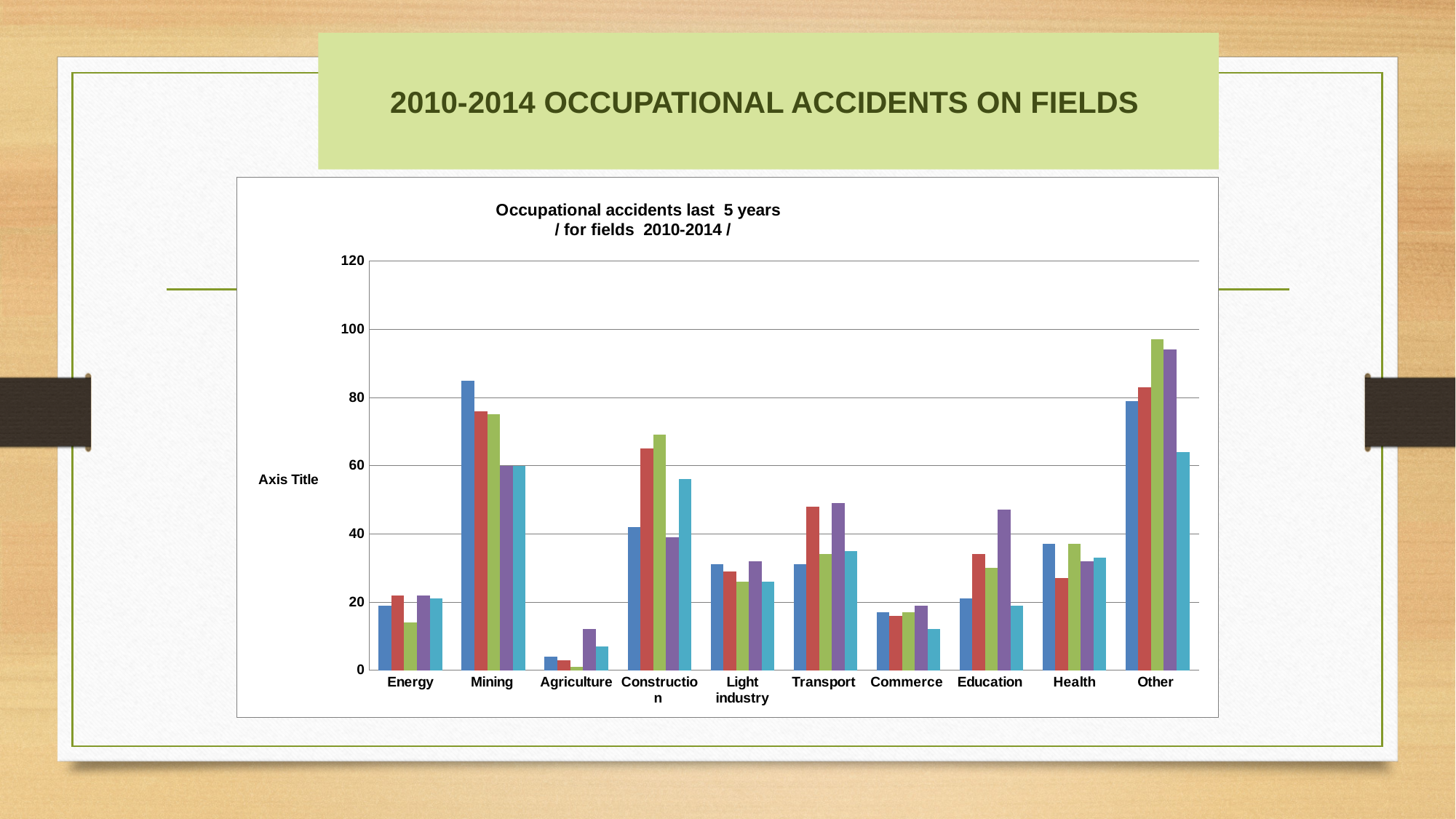
Is the tallest bar for Mining greater or less than 80? greater How many field categories are shown on the x axis of the chart? 10 Which field category contains the tallest bar in the chart? Other Are all the bars for Agriculture greater or less than 20? less How many bars are plotted for each field category? 5 What kind of chart is shown on the slide? bar chart What is the title of the chart? Occupational accidents last 5 years / for fields 2010-2014 / Which category has higher bars overall, Mining or Agriculture? Mining What is the label shown on the vertical axis of the chart? Axis Title Which field category has the lowest bars overall in the chart? Agriculture Is the tallest bar for Other greater or less than 80? greater